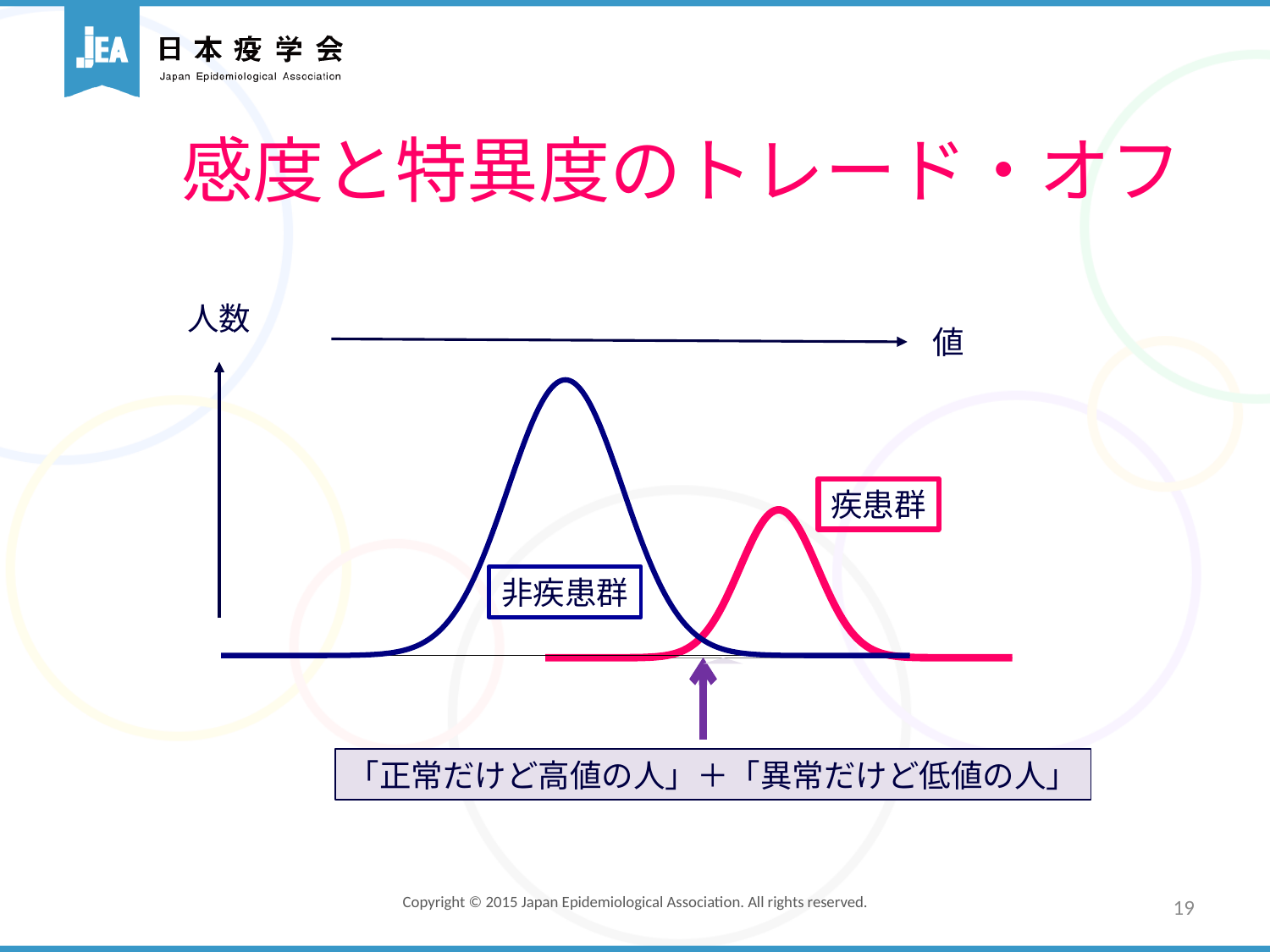
Which group's curve is centered at higher values along the x axis, 非疾患群 or 疾患群? 疾患群 What is the label on the vertical axis of the chart? 人数 Which group has the lowest peak on the chart? 疾患群 What colour is the curve for 疾患群? pink Which group has the highest peak on the chart? 非疾患群 What kind of chart is shown on the slide? line chart How many curves (groups) are plotted on the chart? 2 Which group's curve has the higher peak, 非疾患群 or 疾患群? 非疾患群